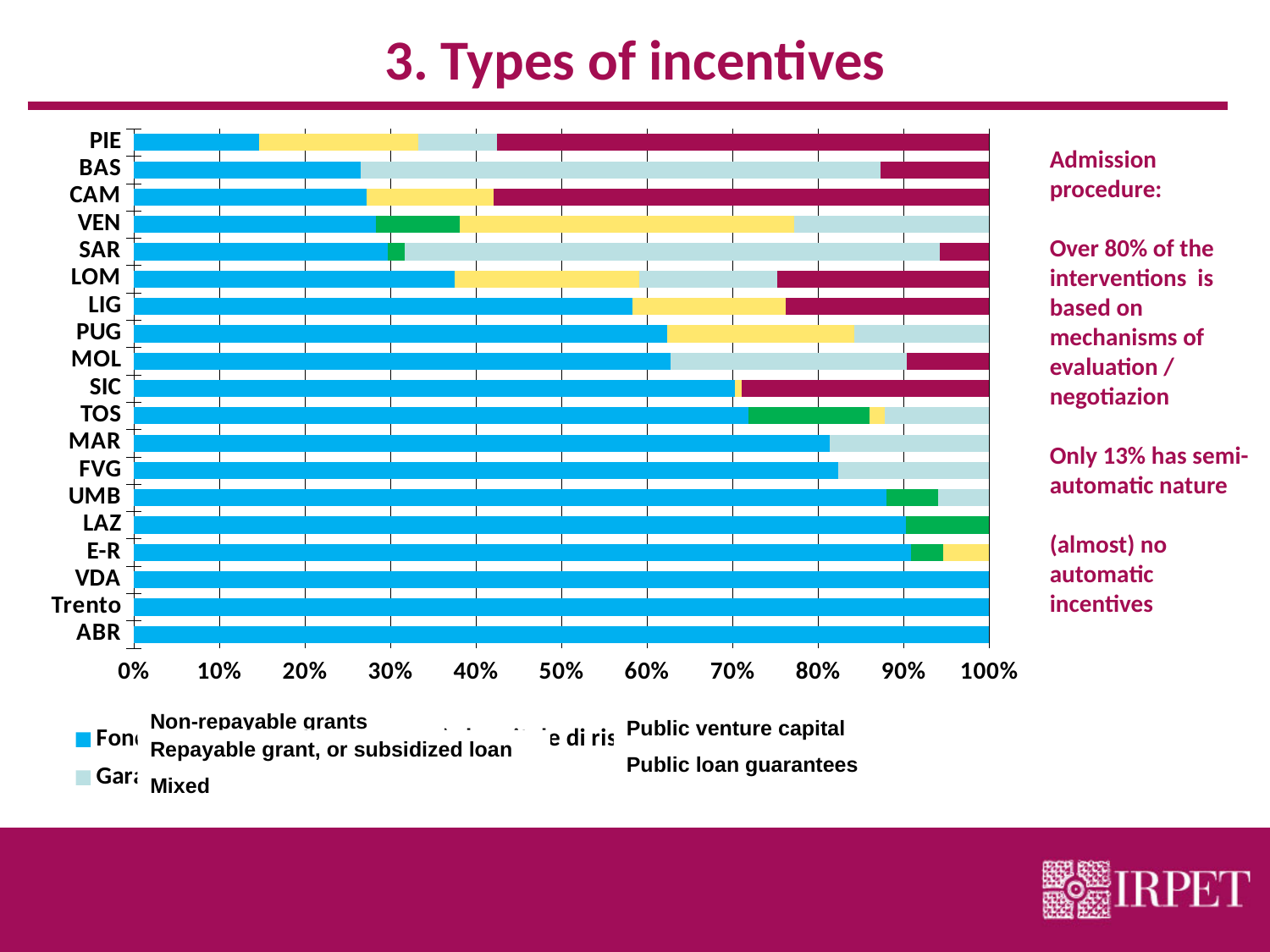
Is the blue (leftmost) segment for BAS greater or less than 30%? less Is the blue (leftmost) segment for LAZ greater or less than 80%? greater What is the title of the slide containing the chart? 3. Types of incentives Which region has the larger blue (leftmost) segment, MAR or PIE? MAR What is the maximum value shown on the horizontal axis? 100% Which region is listed at the top of the vertical axis? PIE Is the blue (leftmost) segment for SIC greater or less than 60%? greater How many regions have a bar that is entirely blue (a single segment reaching 100%)? 3 How many regions (categories) are listed on the vertical axis of the chart? 19 What kind of chart is shown on the slide? Stacked horizontal bar chart